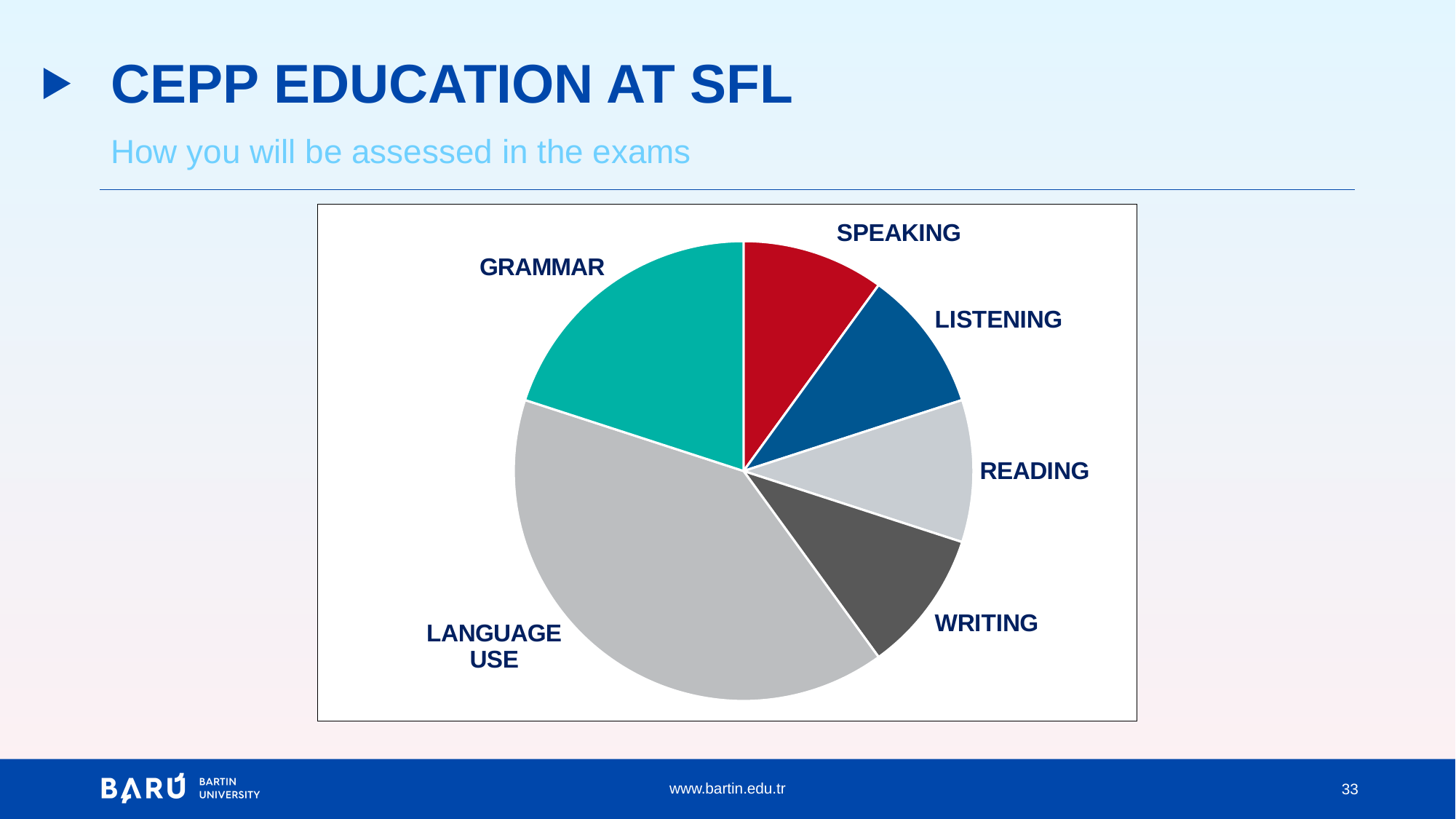
Which slice is larger, GRAMMAR or READING? GRAMMAR What colour is the SPEAKING slice? red What kind of chart is shown on the slide? pie chart Which slice is larger, GRAMMAR or SPEAKING? GRAMMAR Which category is shown in the teal (green-blue) slice? GRAMMAR Which slice is larger, LANGUAGE USE or WRITING? LANGUAGE USE How many slices does the pie chart have? 6 Which category has the largest slice in the pie chart? LANGUAGE USE Which category has the second-largest slice in the pie chart? GRAMMAR